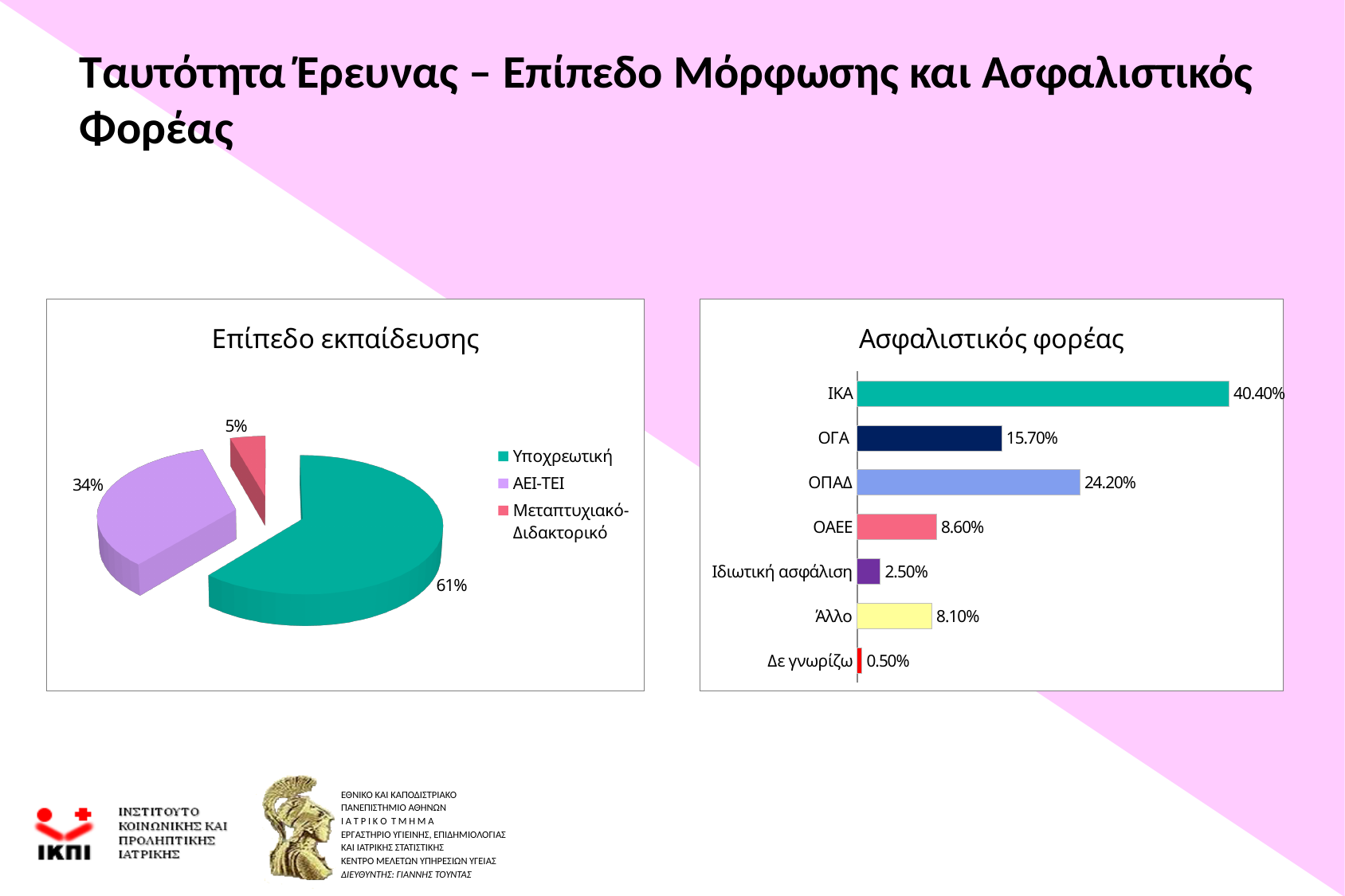
In the 'Ασφαλιστικός φορέας' chart, which is larger, ΟΑΕΕ or Άλλο? ΟΑΕΕ In the 'Επίπεδο εκπαίδευσης' chart, which category has the smallest slice? Μεταπτυχιακό-Διδακτορικό In the 'Επίπεδο εκπαίδευσης' chart, what share does ΑΕΙ-ΤΕΙ have? 34% In the 'Ασφαλιστικός φορέας' chart, which category has the highest value? ΙΚΑ In the 'Ασφαλιστικός φορέας' chart, what is the value for ΟΠΑΔ? 24.20% In the 'Ασφαλιστικός φορέας' chart, which category has the lowest value? Δε γνωρίζω In the 'Επίπεδο εκπαίδευσης' chart, what kind of chart is shown? Pie chart In the 'Ασφαλιστικός φορέας' chart, how many categories are shown? 7 In the 'Επίπεδο εκπαίδευσης' chart, how many categories does the legend list? 3 In the 'Επίπεδο εκπαίδευσης' chart, what share does Υποχρεωτική have? 61% In the 'Ασφαλιστικός φορέας' chart, what is the difference between ΙΚΑ and ΟΓΑ? 24.70% In the 'Ασφαλιστικός φορέας' chart, what is the value for Ιδιωτική ασφάλιση? 2.50%